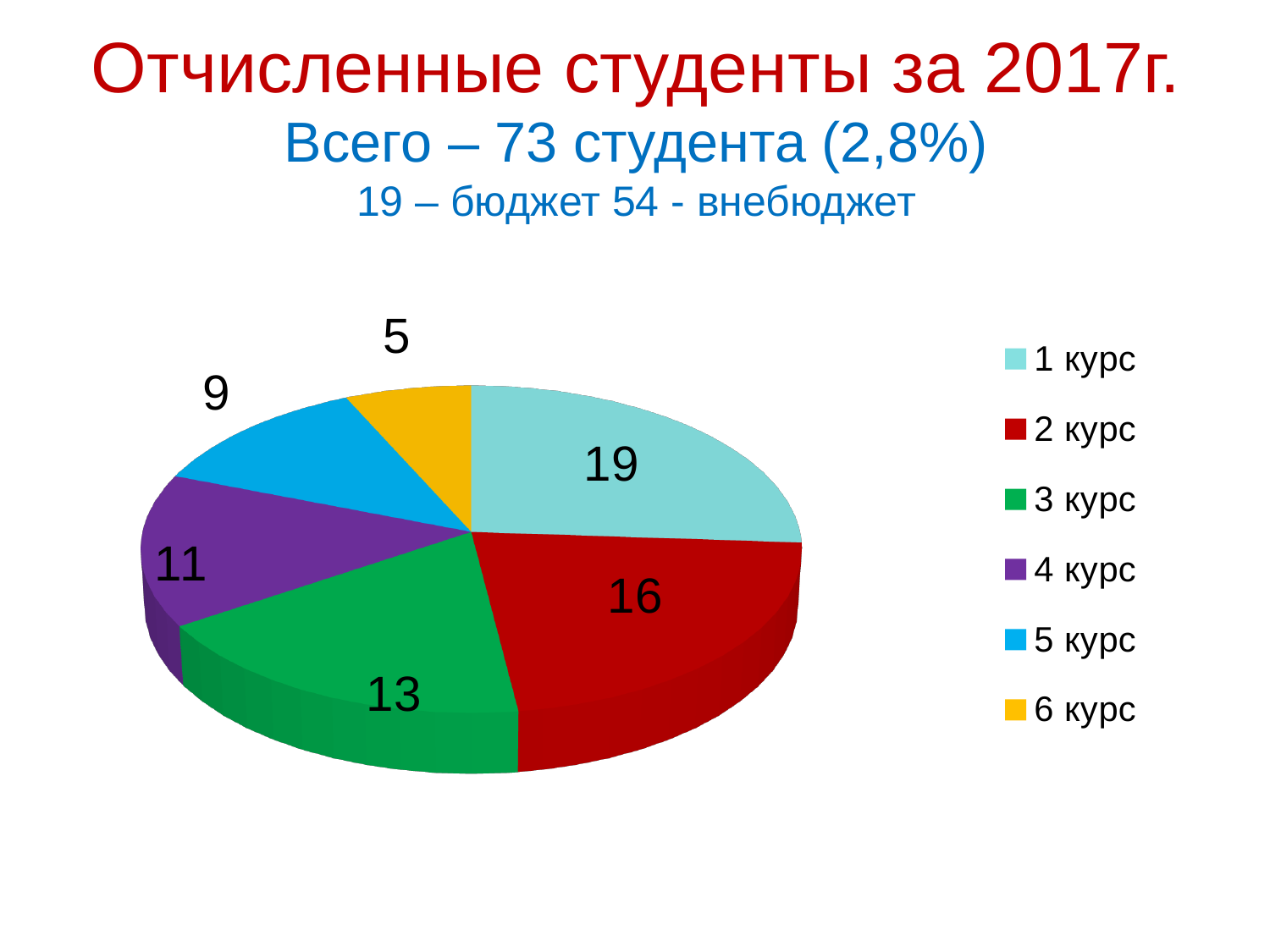
Which course has the largest slice of the pie? 1 курс How many slices does the pie chart have? 6 What is the value for 3 курс? 13 Which is larger, the value for 3 курс or the value for 4 курс? 3 курс Which course has the smallest slice of the pie? 6 курс What colour is the slice for 2 курс? red What is the value for 6 курс? 5 What is the difference between the values for 4 курс and 5 курс? 2 What is the difference between the values for 1 курс and 6 курс? 14 What kind of chart is shown on the slide? pie chart What is the value for 2 курс? 16 What is the value for 1 курс? 19